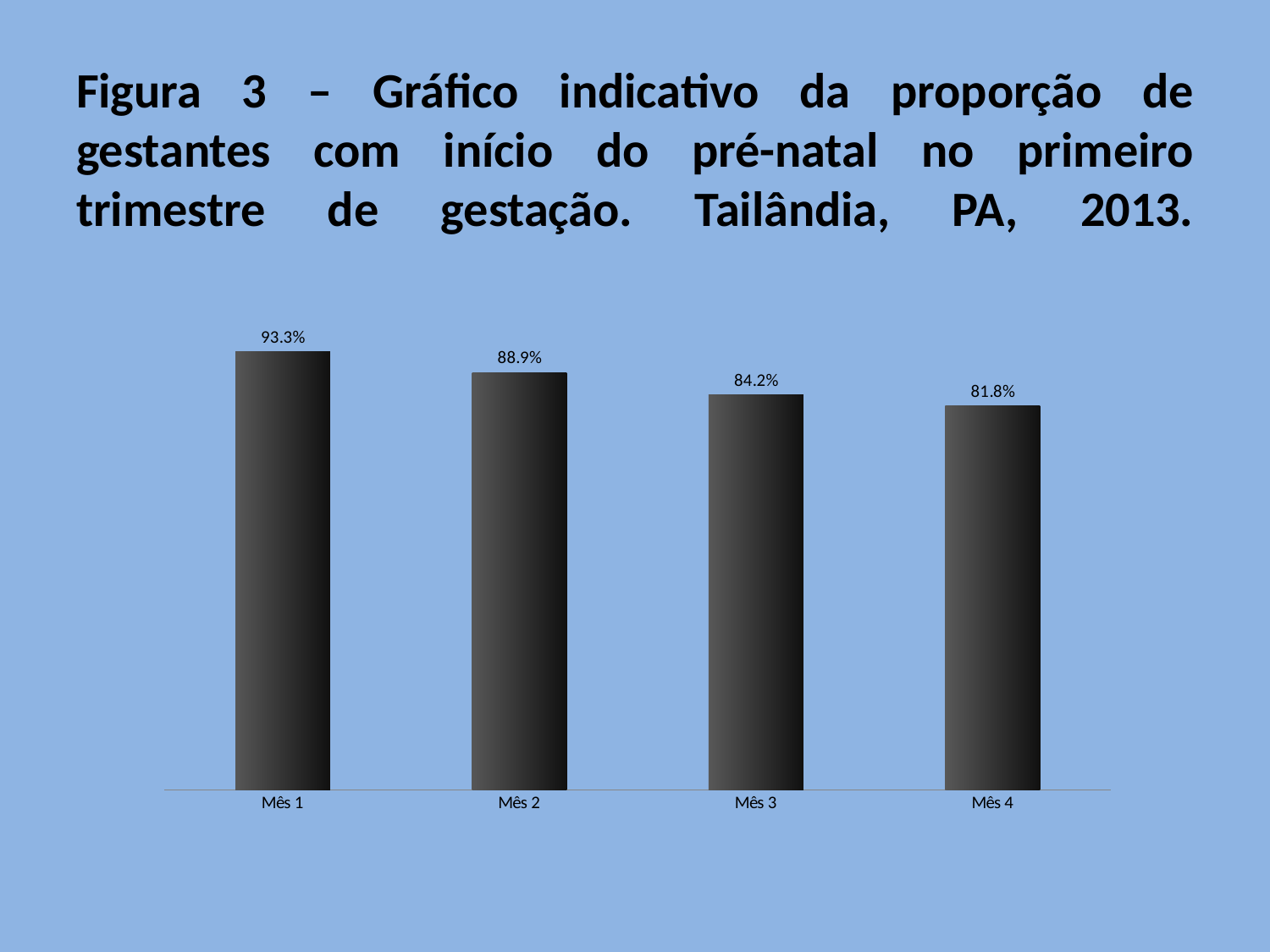
Which month has the lowest value? Mês 4 What is the difference between the values for Mês 1 and Mês 4? 11.5% What kind of chart is shown on the slide? Bar chart What is the value for Mês 1? 93.3% How many categories are shown on the x axis? 4 Which month has the highest value? Mês 1 What is the difference between the values for Mês 2 and Mês 3? 4.7% What is the value for Mês 2? 88.9% Which is larger, the value for Mês 2 or the value for Mês 3? Mês 2 What is the value for Mês 3? 84.2% What is the value for Mês 4? 81.8% Do the values rise or fall from Mês 1 to Mês 4? Fall